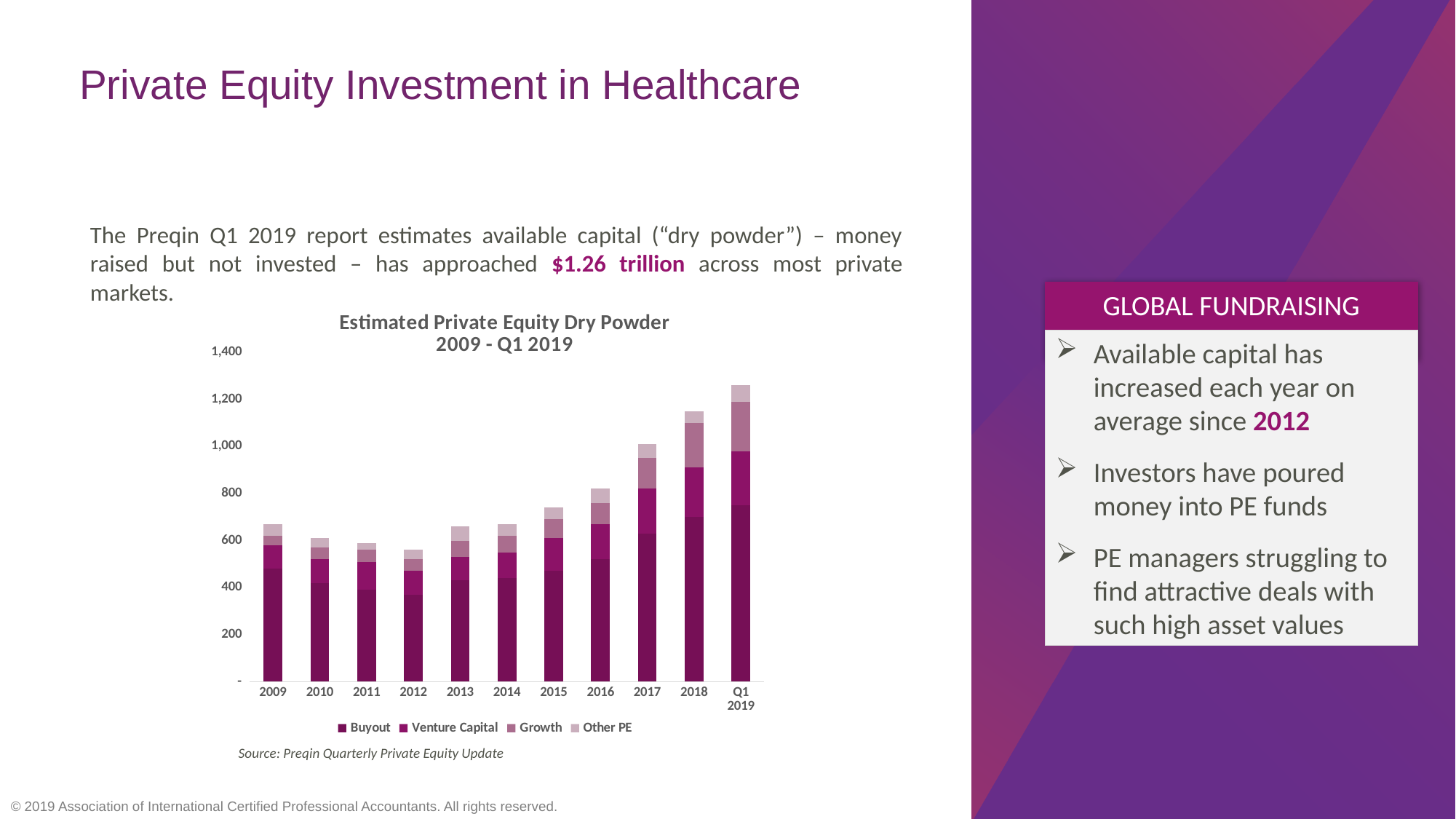
Do the total bar values rise or fall from 2012 to Q1 2019? Rise Is the total value for 2018 greater or less than 1,000? greater Is the total value for Q1 2019 greater or less than 1,200? greater Is the total value for 2012 greater or less than 600? less Which has a larger total estimated dry powder, 2018 or 2013? 2018 How many time periods are shown on the x axis of the chart? 11 What is the title of the chart? Estimated Private Equity Dry Powder 2009 - Q1 2019 Which period has the highest total estimated dry powder? Q1 2019 What kind of chart is shown on the slide? Stacked bar chart How many series does the chart legend list? 4 Which year has the lowest total estimated dry powder? 2012